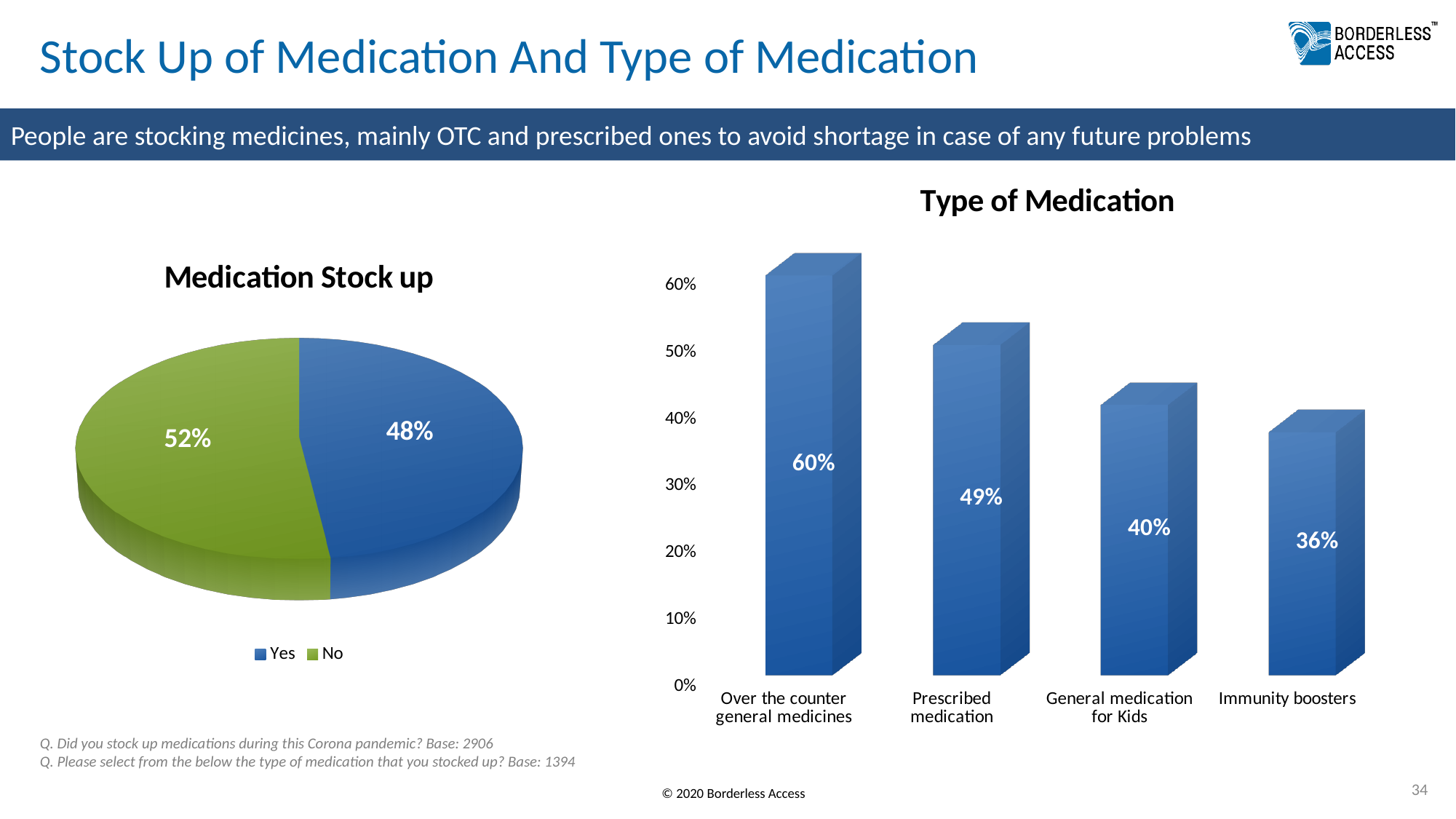
In the 'Type of Medication' chart, what is the value for Immunity boosters? 36% In the 'Type of Medication' chart, what is the difference between Over the counter general medicines and General medication for Kids? 20% In the 'Type of Medication' chart, which category has the lowest value? Immunity boosters How many categories are shown in the 'Type of Medication' chart? 4 In the 'Medication Stock up' chart, what share of respondents answered No? 52% In the 'Type of Medication' chart, do the values rise or fall from left to right? Fall How many entries does the legend of the 'Medication Stock up' chart list? 2 In the 'Type of Medication' chart, what is the value for Prescribed medication? 49% In the 'Medication Stock up' chart, what share of respondents answered Yes? 48% In the 'Type of Medication' chart, which category has the highest value? Over the counter general medicines In the 'Medication Stock up' chart, which slice is larger, Yes or No? No What kind of chart is 'Medication Stock up'? Pie chart